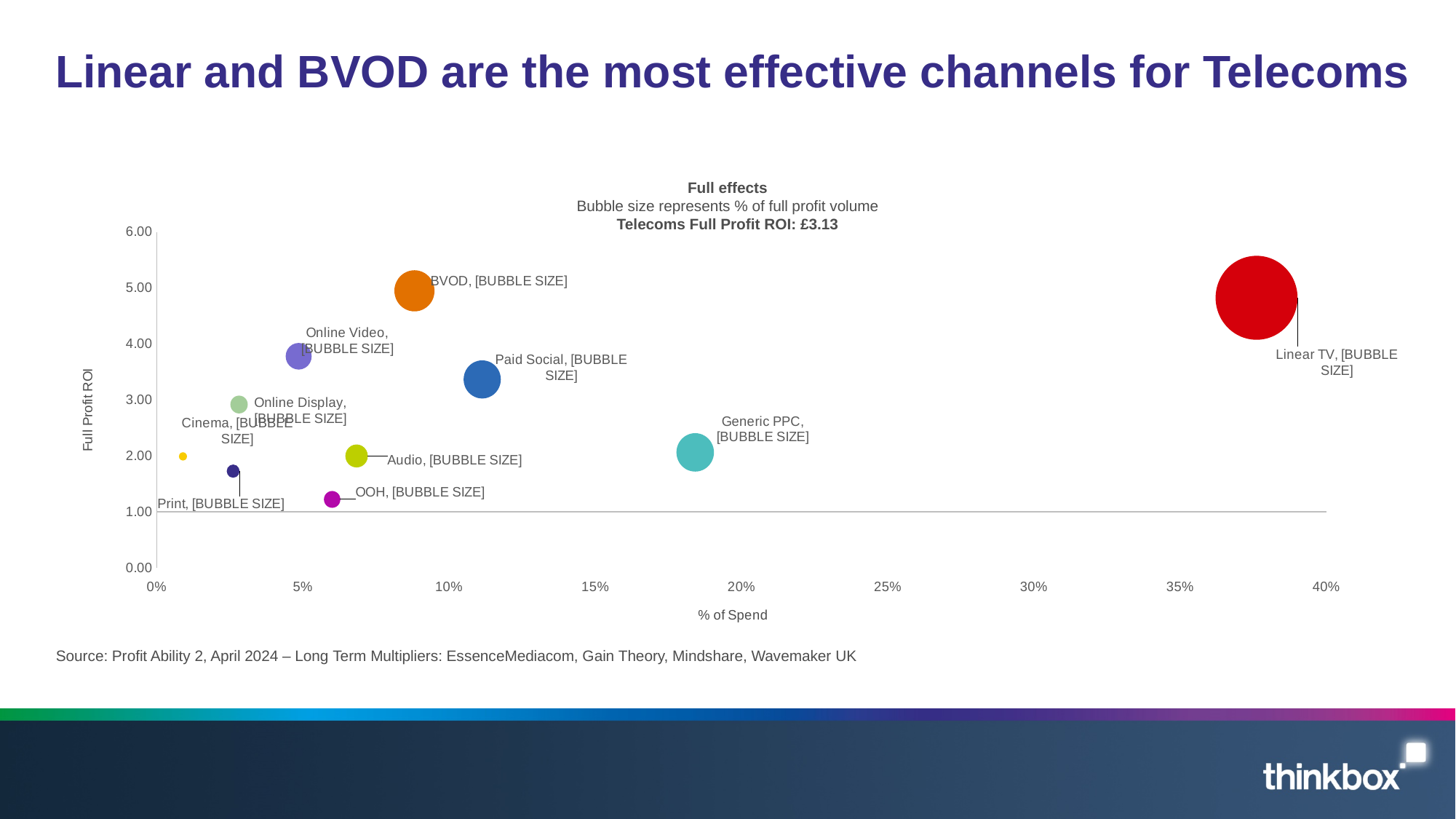
What Telecoms Full Profit ROI figure is stated in the chart subtitle? £3.13 Which channel has the highest % of spend? Linear TV Is the Full Profit ROI for BVOD greater or less than 4.00? greater Is the % of spend for Generic PPC greater or less than 20%? less What kind of chart is shown on the slide? Bubble chart Is the % of spend for Linear TV greater or less than 35%? greater Which channel has the lowest % of spend? Cinema Which has the larger % of spend, Generic PPC or Audio? Generic PPC Which has the higher Full Profit ROI, Paid Social or Online Display? Paid Social How many channels are plotted as bubbles on the chart? 10 Which channel has the lowest Full Profit ROI? OOH